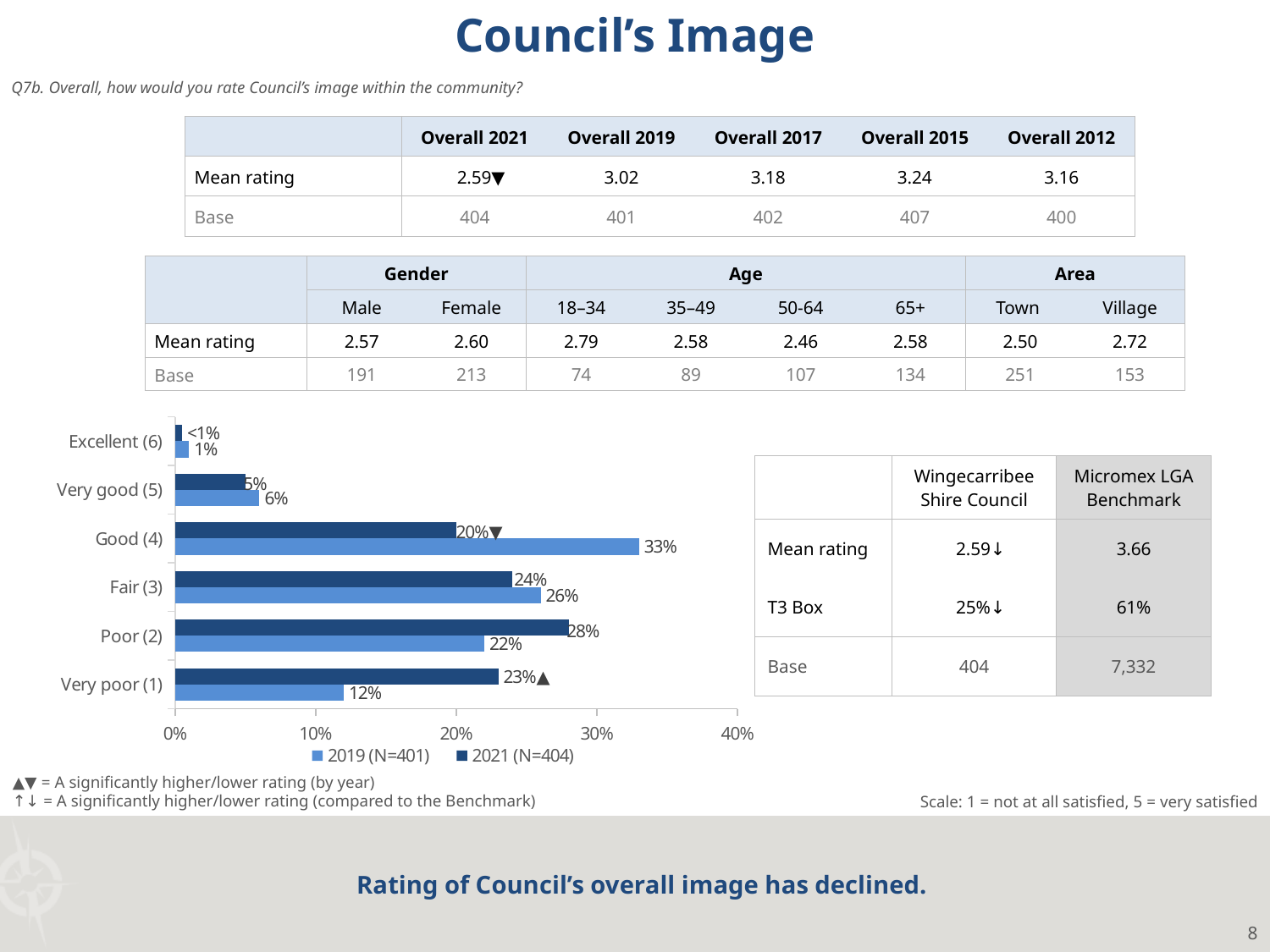
Which category has the highest 2021 value? Poor (2) What is the 2021 value for Poor (2)? 28% How many series does the chart legend list? 2 What is the 2019 value for Fair (3)? 26% Which category has the highest 2019 value? Good (4) What is the difference between the 2019 and 2021 values for Good (4)? 13% Which series is shown in the darker blue colour in the legend? 2021 (N=404) How many rating categories are plotted on the chart? 6 What is the 2019 value for Good (4)? 33% What kind of chart is shown on the slide? bar chart What is the 2021 value for Very poor (1)? 23% Which is larger for Very poor (1): the 2019 value or the 2021 value? 2021